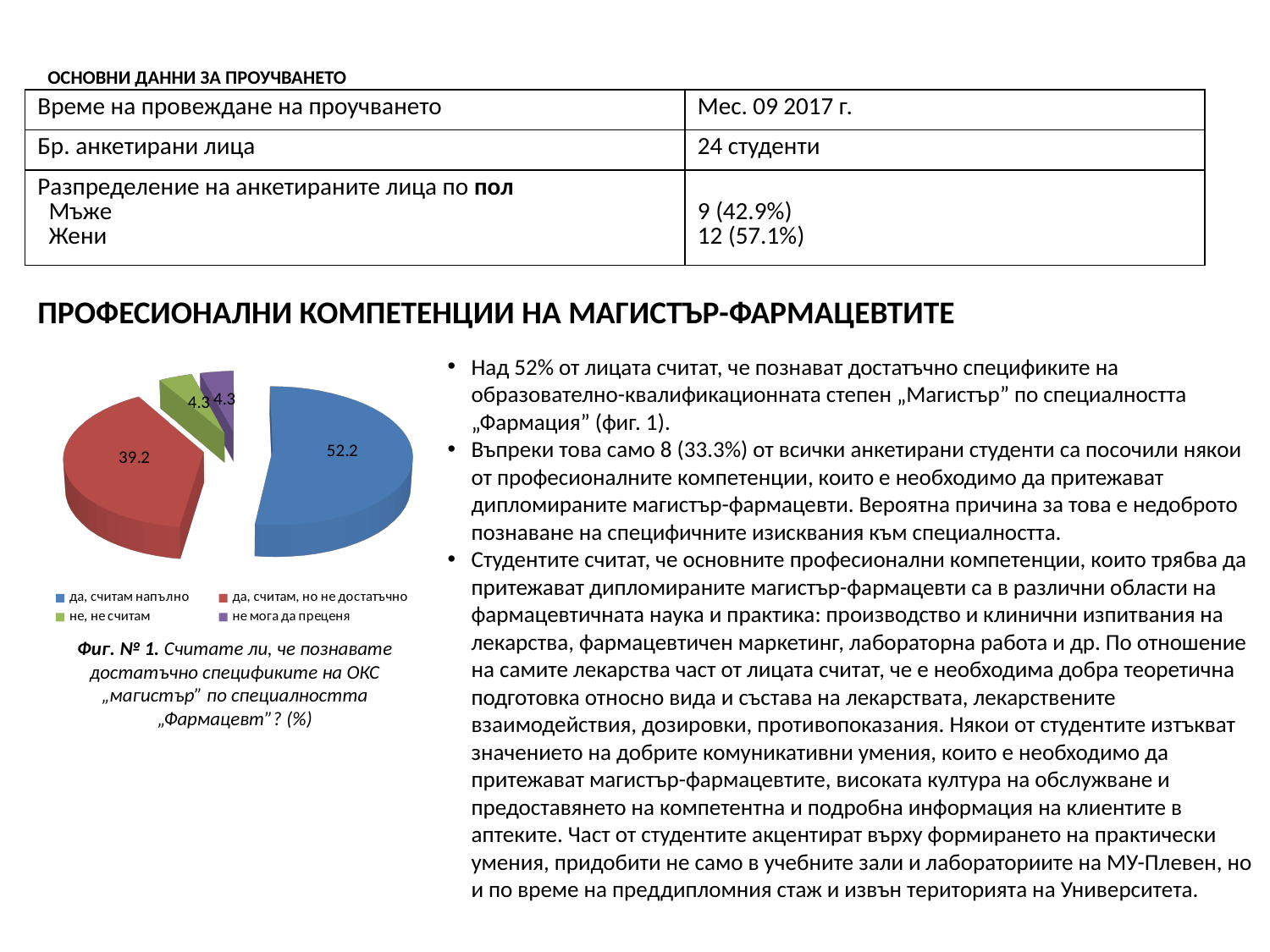
Which is larger: "да, считам напълно" or "да, считам, но не достатъчно"? да, считам напълно What value is shown for the slice "да, считам напълно"? 52.2 What colour is the slice for "да, считам, но не достатъчно"? red What value is shown for the slice "не мога да преценя"? 4.3 How many slices does the pie chart have? 4 What share of the pie does the slice "да, считам напълно" represent? 52.2% What value is shown for the slice "не, не считам"? 4.3 How many entries does the legend list? 4 What value is shown for the slice "да, считам, но не достатъчно"? 39.2 What is the difference between the values for "да, считам напълно" and "да, считам, но не достатъчно"? 13 What kind of chart is shown on the slide? pie chart Which category has the largest slice of the pie? да, считам напълно